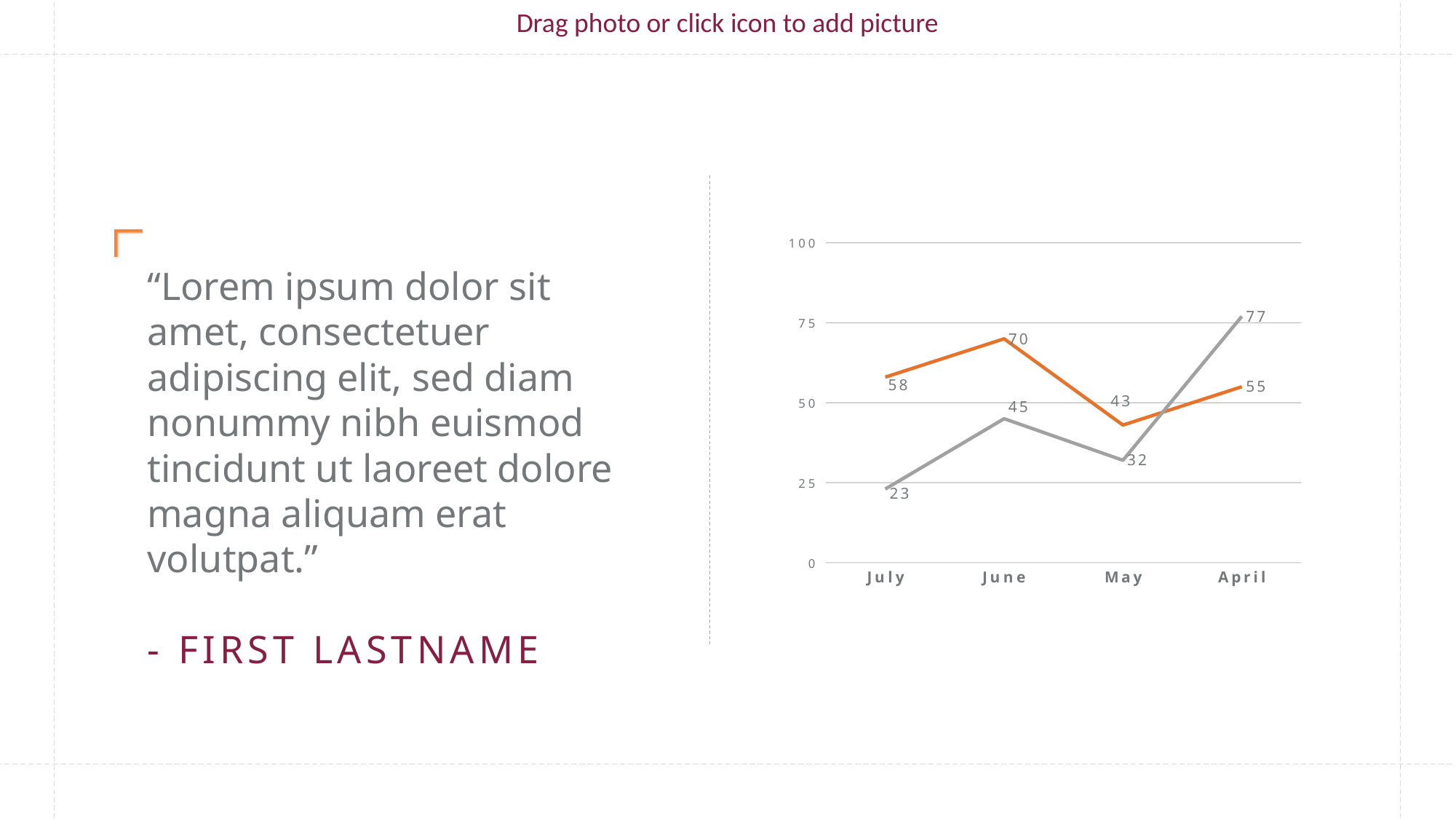
What is the value of the gray line for April? 77 In which category does the orange line have its lowest value? May Does the gray line rise or fall from May to April? rise How many categories are shown on the x axis of the chart? 4 What type of chart is shown on the slide? line chart What is the value of the orange line for June? 70 In which category does the gray line reach its highest value? April Is the gray line's value for May greater or less than 50? less Which line has the larger value for April, the orange line or the gray line? gray line What is the difference between the orange line's value for July and the gray line's value for July? 35 What is the value of the orange line for May? 43 What is the value of the gray line for July? 23